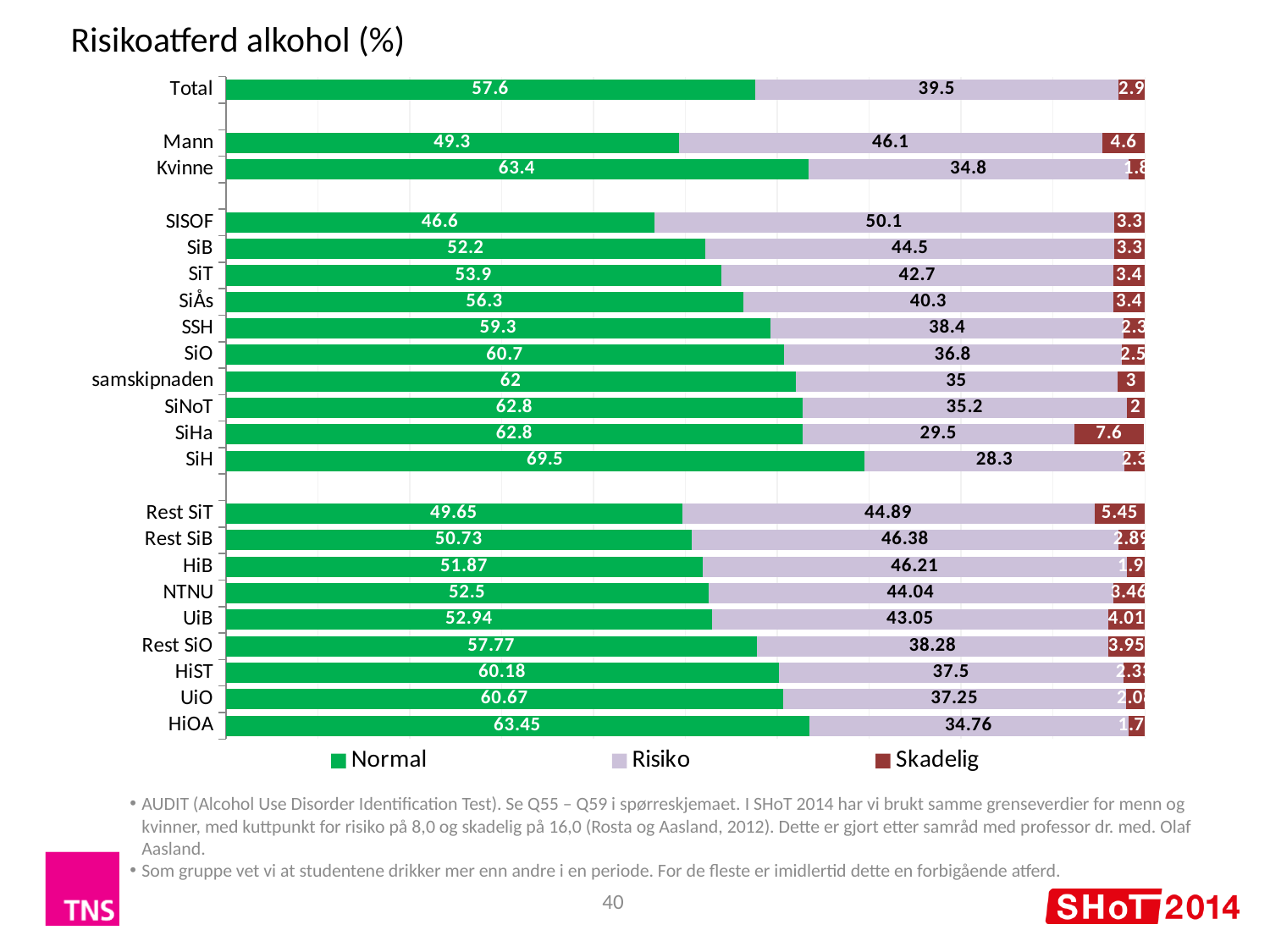
What is the Risiko value for SISOF? 50.1 What is the total of the stacked bar for Total? 100 Which category has the highest Skadelig value? SiHa What is the Risiko value for Mann? 46.1 How many series does the legend list? 3 Which has the larger Risiko value, SiB or SiT? SiB What is the Normal value for Total? 57.6 What is the difference between the Normal values for Kvinne and Mann? 14.1 What kind of chart is shown on the slide? Stacked bar chart Which category has the lowest Normal value? SISOF What is the Skadelig value for SiHa? 7.6 Which category has the highest Normal value? SiH